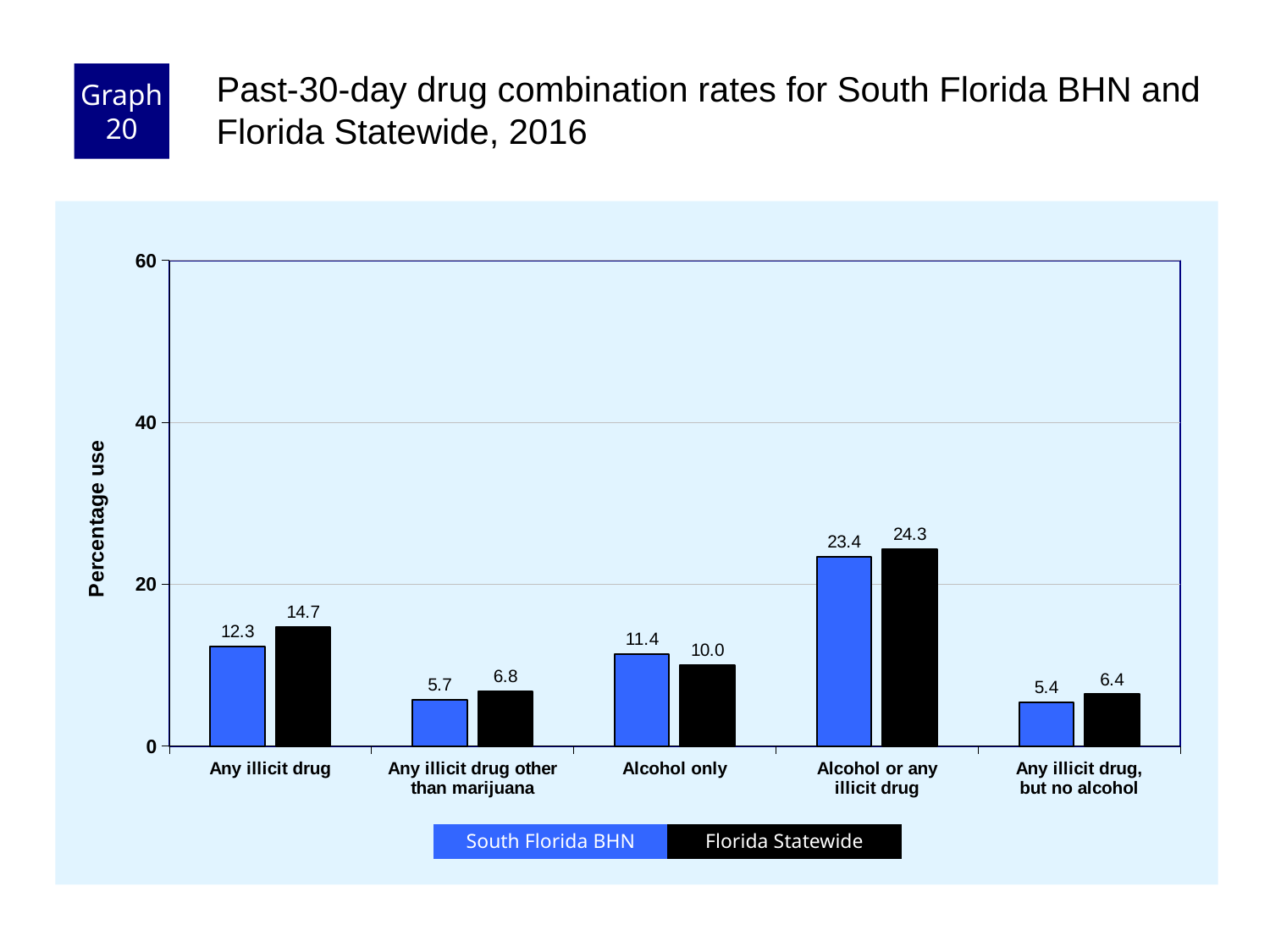
Which category has the lowest Florida Statewide value? Any illicit drug, but no alcohol How many series does the legend list? 2 What is the Florida Statewide value for Any illicit drug, but no alcohol? 6.4 How many categories are shown on the x axis? 5 What is the label of the y axis? Percentage use What is the Florida Statewide value for Alcohol only? 10.0 Which category has the highest South Florida BHN value? Alcohol or any illicit drug Which is larger for Alcohol only: South Florida BHN or Florida Statewide? South Florida BHN Is the Florida Statewide value for Alcohol or any illicit drug greater or less than 20? greater What is the difference between the Florida Statewide and South Florida BHN values for Any illicit drug? 2.4 What kind of chart is shown? bar chart What is the South Florida BHN value for Any illicit drug? 12.3